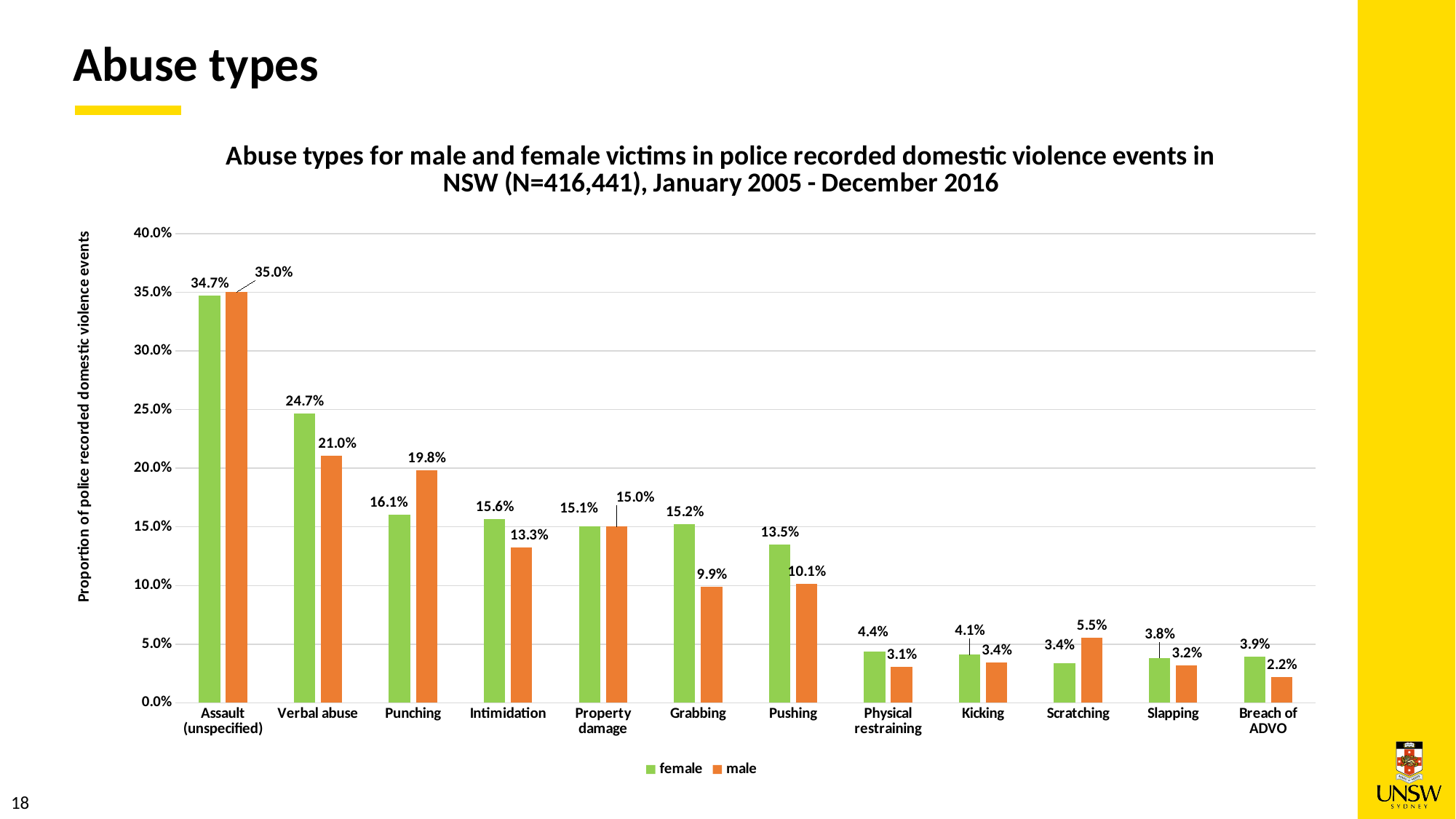
What colour represents the male series in the chart? orange What is the male value for Breach of ADVO? 2.2% Is the female value for Pushing greater or less than 10.0%? greater What kind of chart is shown on the slide? bar chart What is the difference between the female and male values for Grabbing? 5.3% Which is larger for Scratching, the female value or the male value? male Which abuse type has the highest male value? Assault (unspecified) How many series does the legend list? 2 What is the female value for Verbal abuse? 24.7% How many abuse type categories are shown on the x axis? 12 Which abuse type has the lowest female value? Scratching What is the male value for Punching? 19.8%